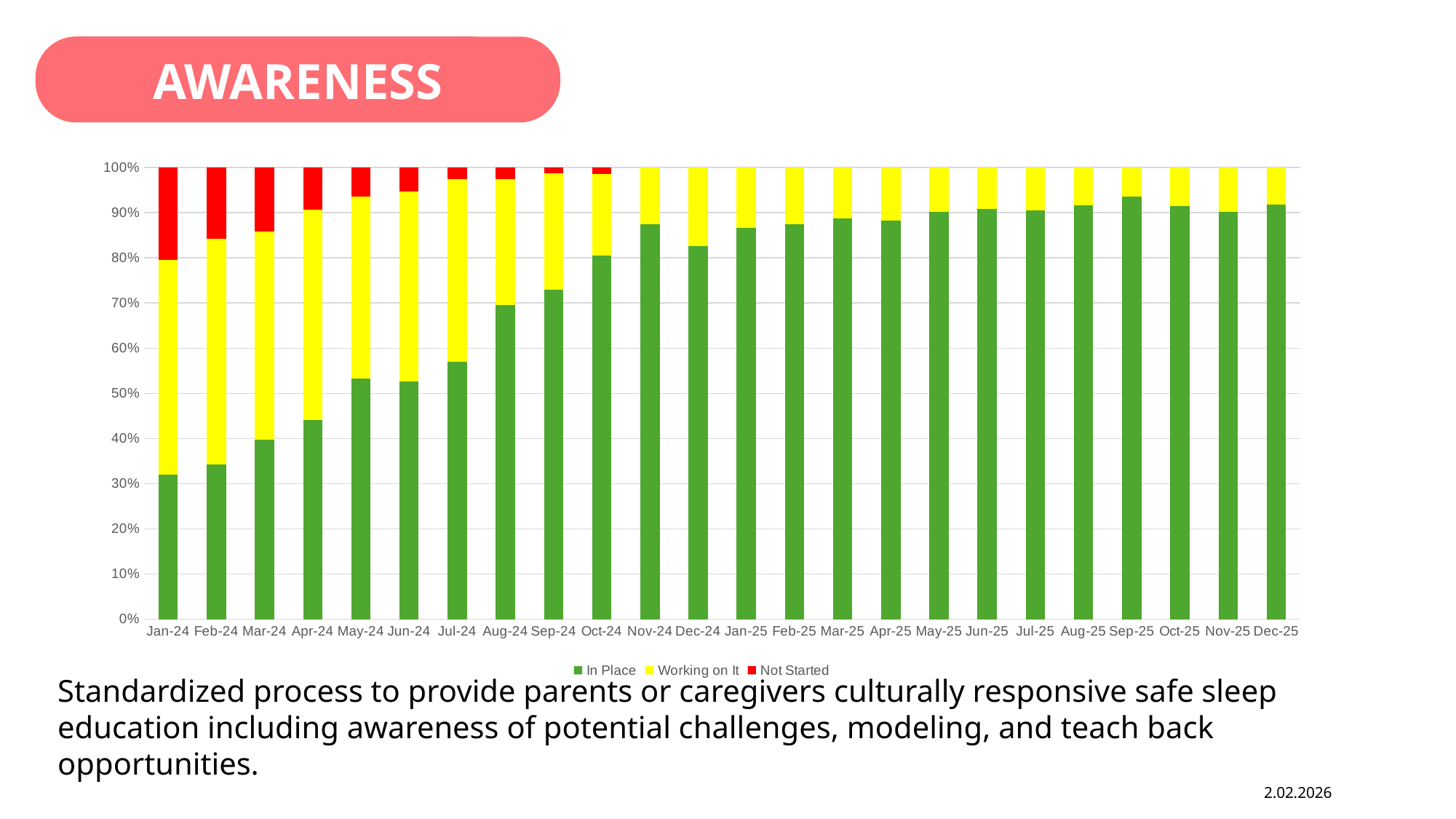
Which series is shown in green? In Place Which month has the largest Not Started share? Jan-24 Which month has the lowest In Place share? Jan-24 What are the three legend entries? In Place, Working on It, Not Started What kind of chart is shown on the slide? Stacked bar chart Is the In Place value for Dec-24 greater or less than 80%? greater How many series does the legend list? 3 Is the In Place value for Jan-24 greater or less than 30%? greater Which is larger, the In Place share for Jan-24 or for Dec-25? Dec-25 Does the In Place share generally rise or fall from Jan-24 to Dec-25? rise Is the In Place value for Jul-24 greater or less than 60%? less How many months (categories) are shown on the x axis? 24